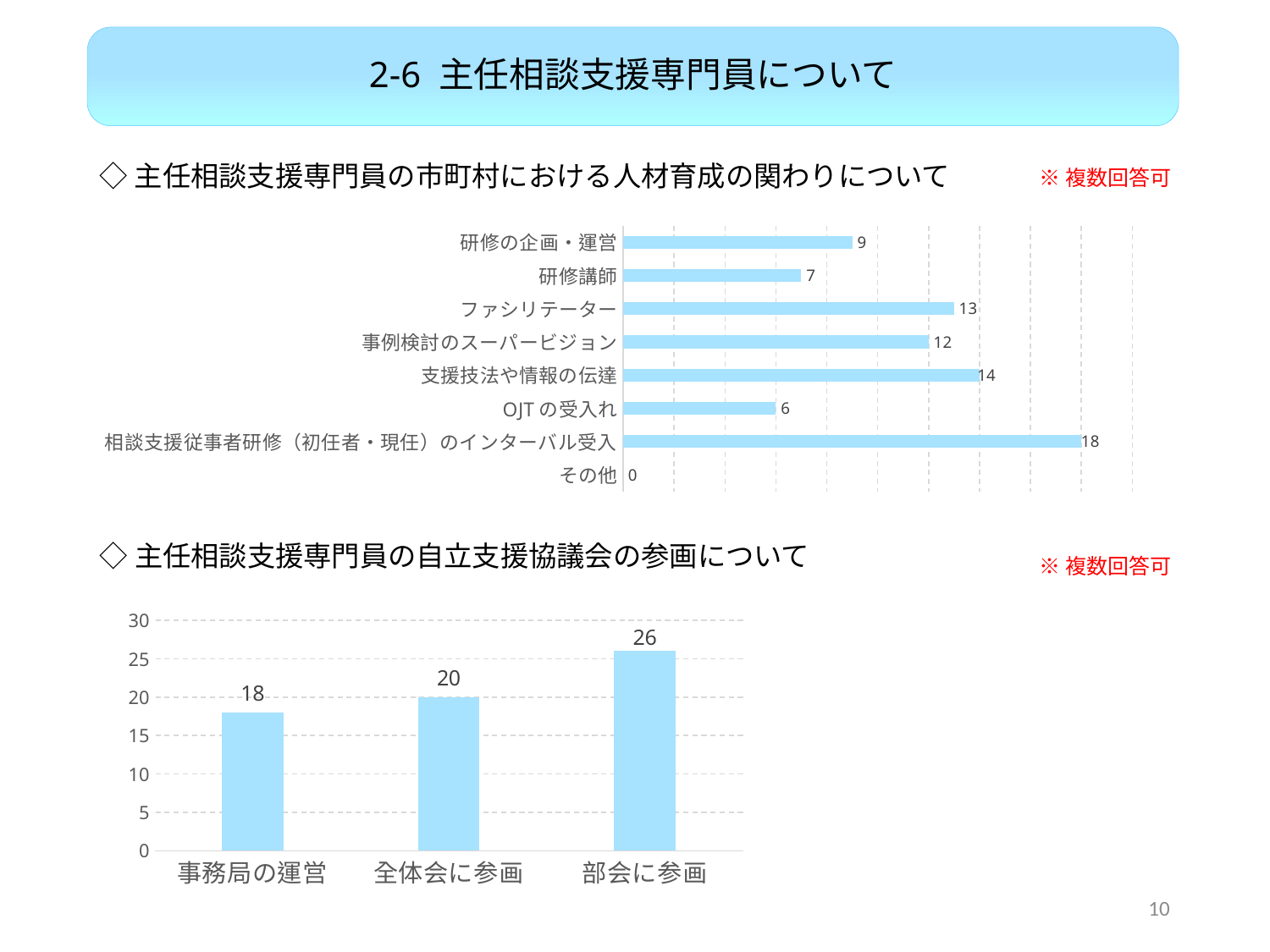
In the bottom chart (自立支援協議会の参画), which category has the highest value? 部会に参画 In the top chart (人材育成の関わり), which category has the lowest value? その他 In the top chart (人材育成の関わり), what is the value for ファシリテーター? 13 In the top chart (人材育成の関わり), which is larger: 研修の企画・運営 or 事例検討のスーパービジョン? 事例検討のスーパービジョン What kind of chart is the top chart (人材育成の関わり)? Bar chart In the top chart (人材育成の関わり), what is the value for OJTの受入れ? 6 In the top chart (人材育成の関わり), what is the difference between 支援技法や情報の伝達 and 研修講師? 7 In the bottom chart (自立支援協議会の参画), what is the value for 全体会に参画? 20 How many categories are shown in the top chart (人材育成の関わり)? 8 In the top chart (人材育成の関わり), which category has the highest value? 相談支援従事者研修（初任者・現任）のインターバル受入 In the bottom chart (自立支援協議会の参画), what is the difference between 部会に参画 and 事務局の運営? 8 How many categories are shown in the bottom chart (自立支援協議会の参画)? 3